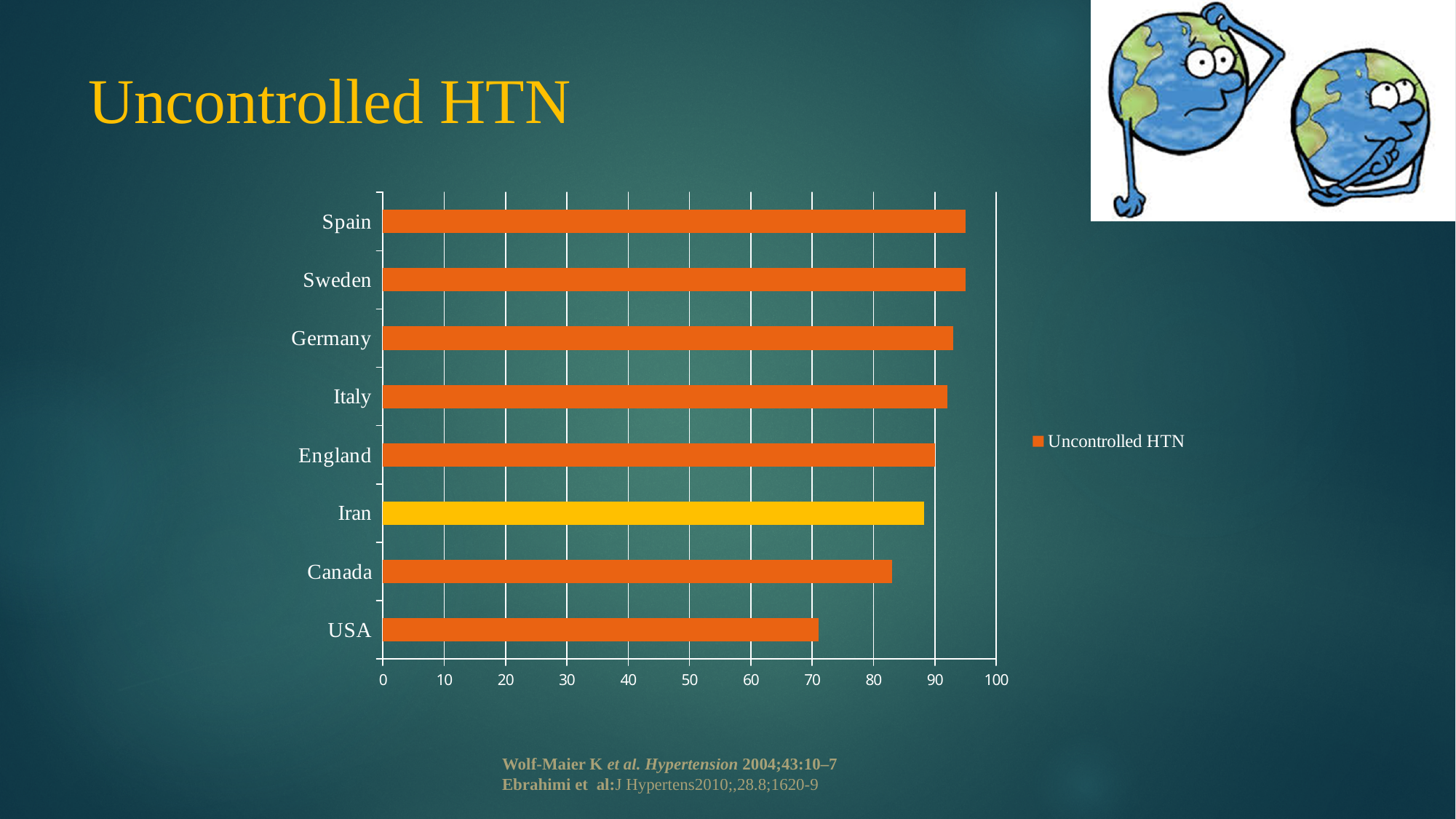
Which has a larger value, Iran or Canada? Iran Is the value for USA greater or less than 80? less Is the value for Spain greater or less than 90? greater Is the value for Canada greater or less than 80? greater Which has a larger value, USA or Canada? Canada What kind of chart is shown on the slide? bar chart How many countries are shown in the chart? 8 Which country has the lowest value for Uncontrolled HTN? USA Which country's bar is coloured differently (yellow) from the others? Iran What is the name of the series shown in the legend? Uncontrolled HTN How many series does the legend list? 1